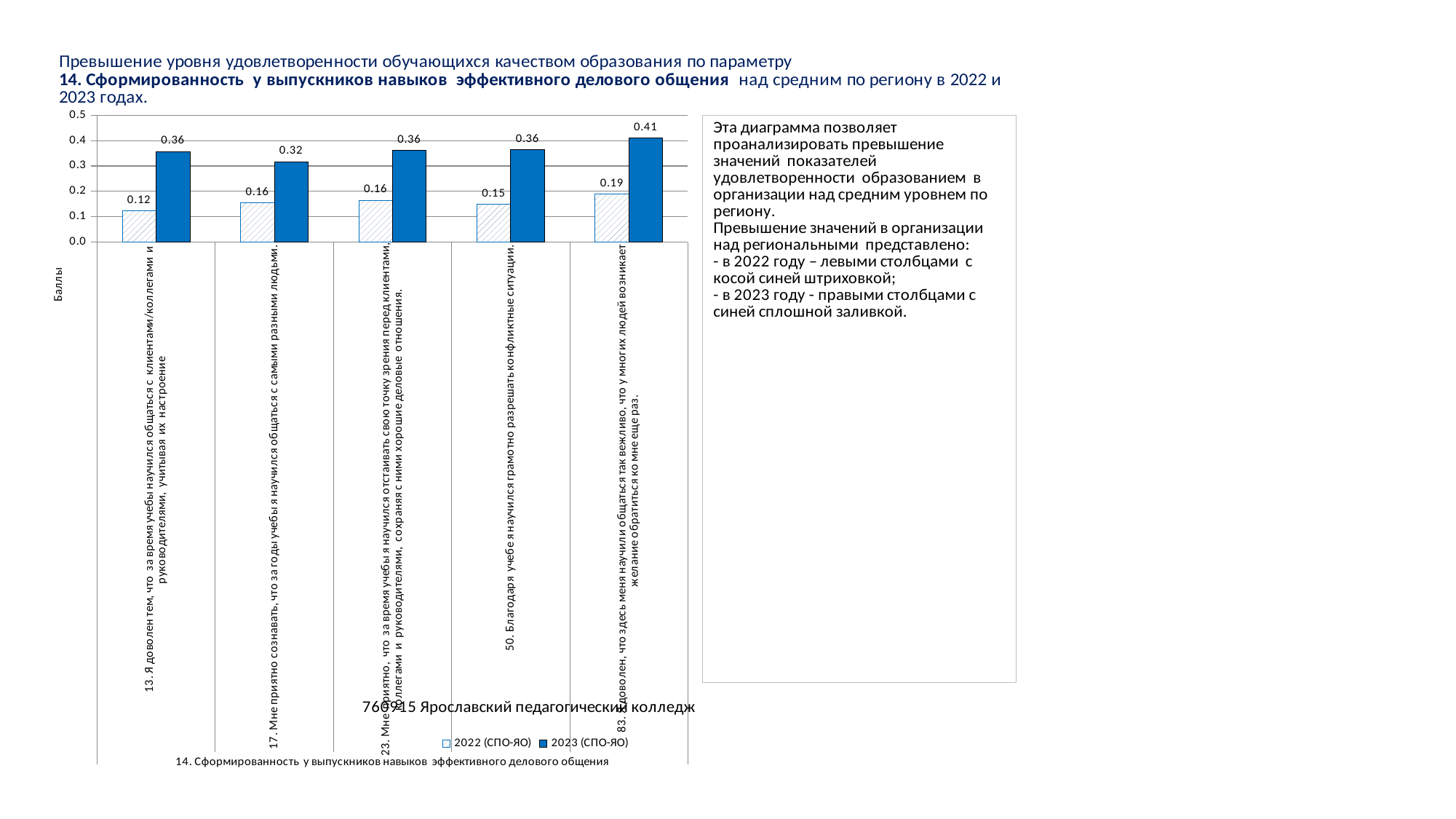
Which statement has the lowest value in the 2022 (СПО-ЯО) series? 13. Я доволен тем, что за время учебы научился общаться с клиентами/коллегами и руководителями, учитывая их настроение What is the value for the 2022 (СПО-ЯО) series for statement 50 ("Благодаря учебе я научился грамотно разрешать конфликтные ситуации")? 0.15 Is the 2023 (СПО-ЯО) value for statement 83 greater or less than 0.4? greater Which statement has the highest value in the 2023 (СПО-ЯО) series? 83. Я доволен, что здесь меня научили общаться так вежливо, что у многих людей возникает желание обратиться ко мне еще раз. How many statements (categories) are shown on the x axis of the chart? 5 What kind of chart is shown on the slide? Bar chart How many series does the chart legend list? 2 For statement 17, which series has the larger value: 2022 (СПО-ЯО) or 2023 (СПО-ЯО)? 2023 (СПО-ЯО) What is the value for the 2023 (СПО-ЯО) series for statement 17 ("Мне приятно сознавать, что за годы учебы я научился общаться с самыми разными людьми")? 0.32 What is the value for the 2023 (СПО-ЯО) series for statement 83 ("Я доволен, что здесь меня научили общаться так вежливо...")? 0.41 What is the value for the 2022 (СПО-ЯО) series for statement 13 ("Я доволен тем, что за время учебы научился общаться с клиентами/коллегами и руководителями...")? 0.12 What is the difference between the 2023 (СПО-ЯО) and 2022 (СПО-ЯО) values for statement 83? 0.22